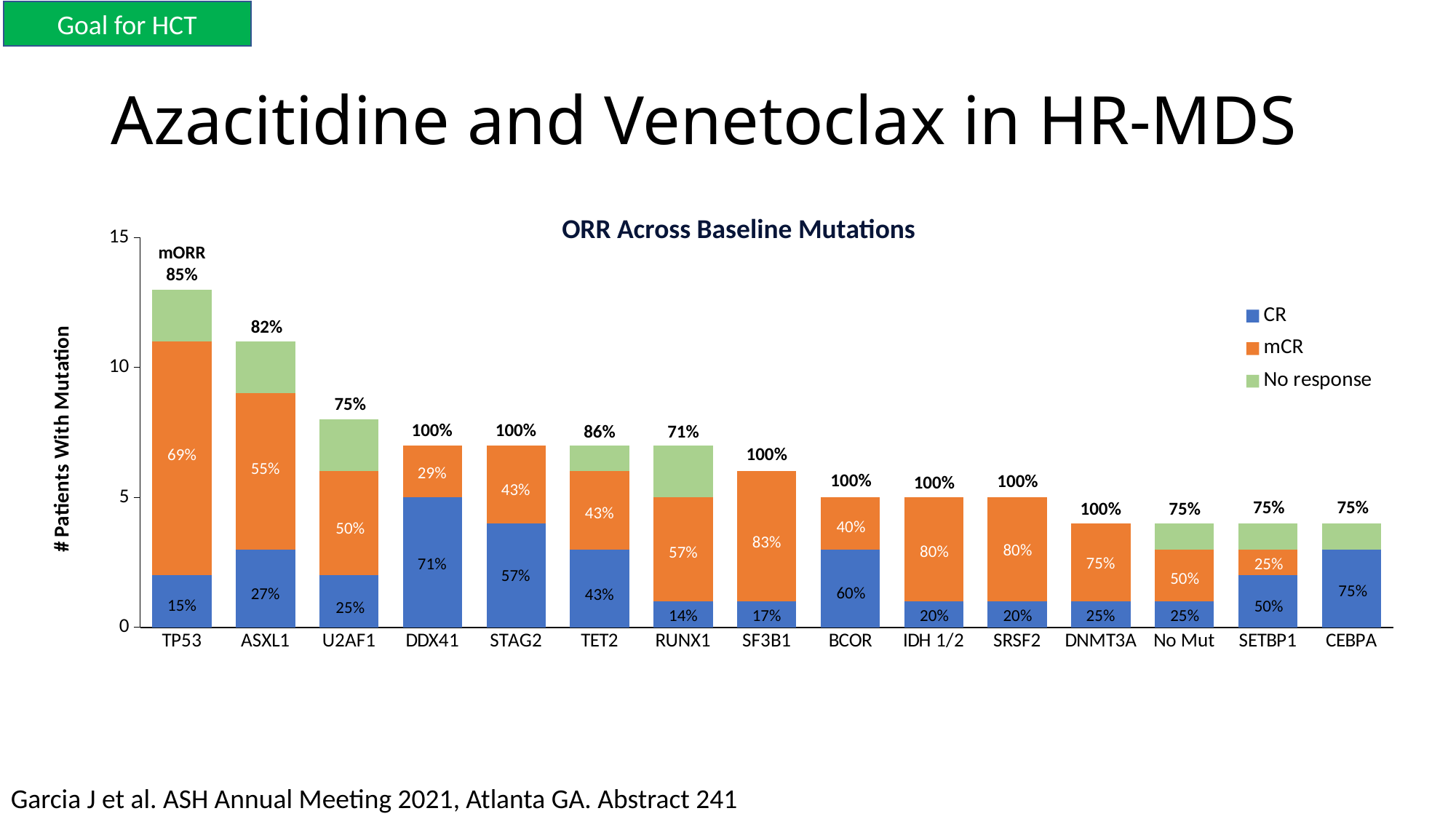
What is the difference between the mORR for TP53 and the mORR for ASXL1? 3% What is the mORR shown above the TP53 bar? 85% Is the number of patients with the TP53 mutation greater or less than 10? greater What kind of chart is shown on the slide? Stacked bar chart Which mutation has more patients, TP53 or ASXL1? TP53 What CR percentage is labelled on the DDX41 bar? 71% Which mutation has the tallest bar (most patients with the mutation)? TP53 How many mutation categories are shown along the x axis? 15 What are the three legend entries in the chart? CR, mCR, No response Which mutation has the lowest mORR shown above its bar? RUNX1 How many series does the legend list in the ORR Across Baseline Mutations chart? 3 What mCR percentage is labelled on the SF3B1 bar? 83%